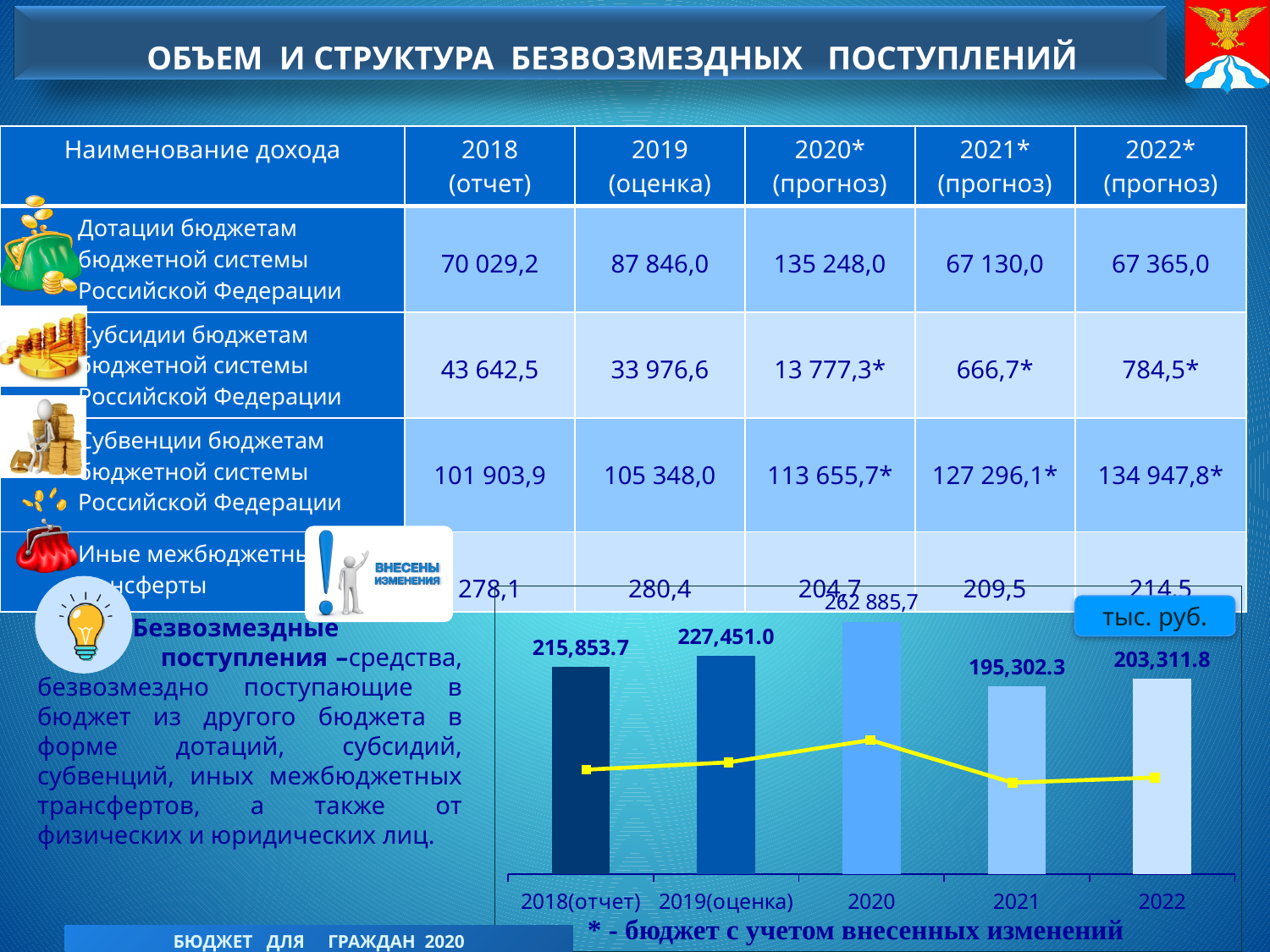
Which is larger, the bar for 2018(отчет) or the bar for 2021? 2018(отчет) What is the difference between the 2022 and 2021 bar values? 8,009.5 Which year has the lowest bar in the chart? 2021 How many years are shown on the x axis of the bar chart? 5 What is the value shown for 2019(оценка) in the bar chart? 227,451.0 By how much does the 2019(оценка) bar exceed the 2018(отчет) bar? 11,597.3 What kind of chart is shown at the bottom right of the slide? bar chart Do the bar values rise or fall from 2020 to 2021? fall What is the value shown for 2018(отчет) in the bar chart? 215,853.7 What is the value shown for 2022 in the bar chart? 203,311.8 Which year has the tallest bar in the chart? 2020 What is the value shown for 2021 in the bar chart? 195,302.3